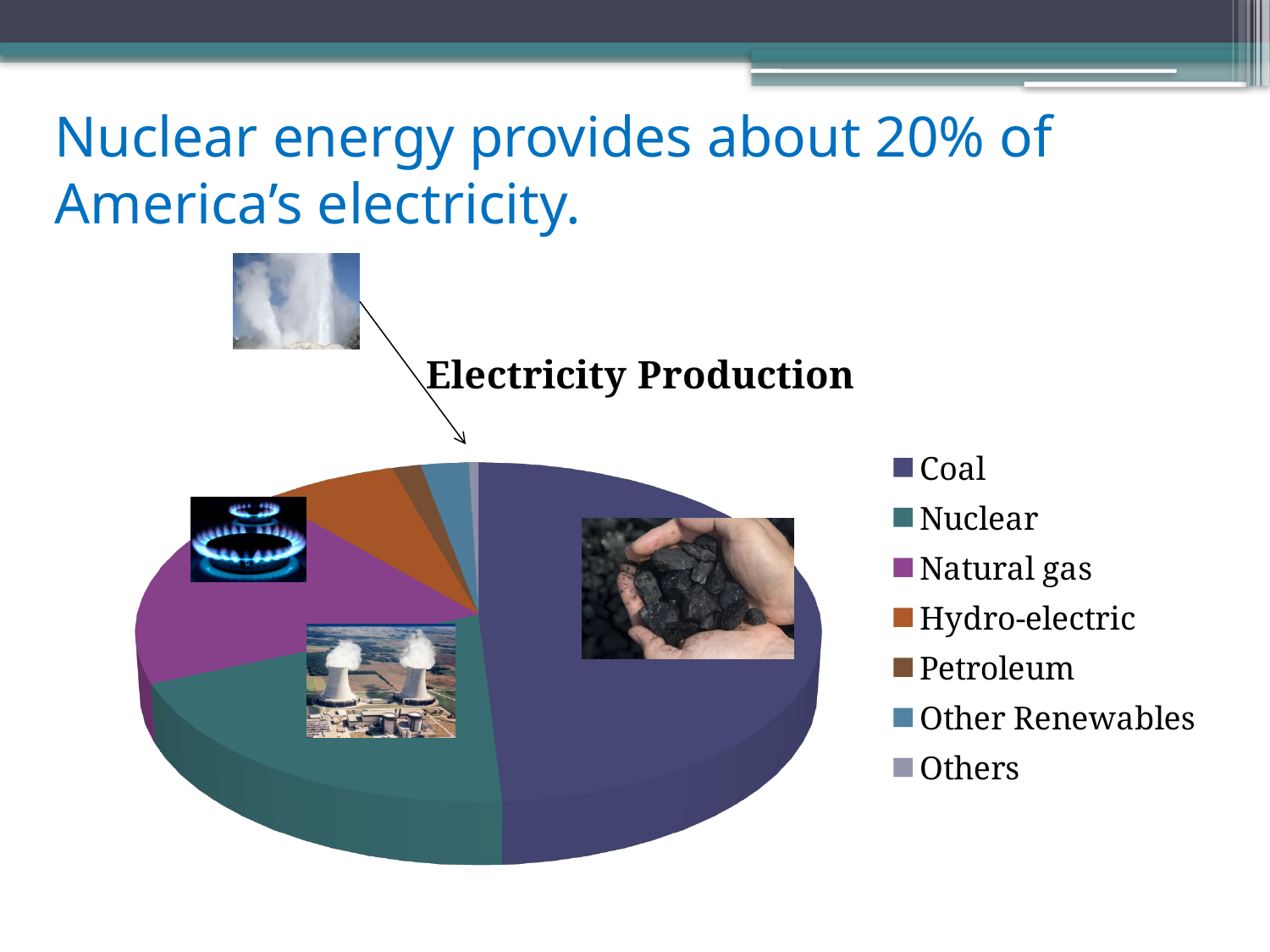
Which slice is larger, Other Renewables or Others? Other Renewables What is the title of the chart? Electricity Production Which category has the smallest slice of the pie? Others How many categories does the pie chart have? 7 Which legend entry is listed last in the chart's legend? Others Which slice is larger, Coal or Nuclear? Coal Which slice is larger, Coal or Natural gas? Coal What kind of chart is shown on the slide? pie chart Which category has the largest slice of the pie? Coal